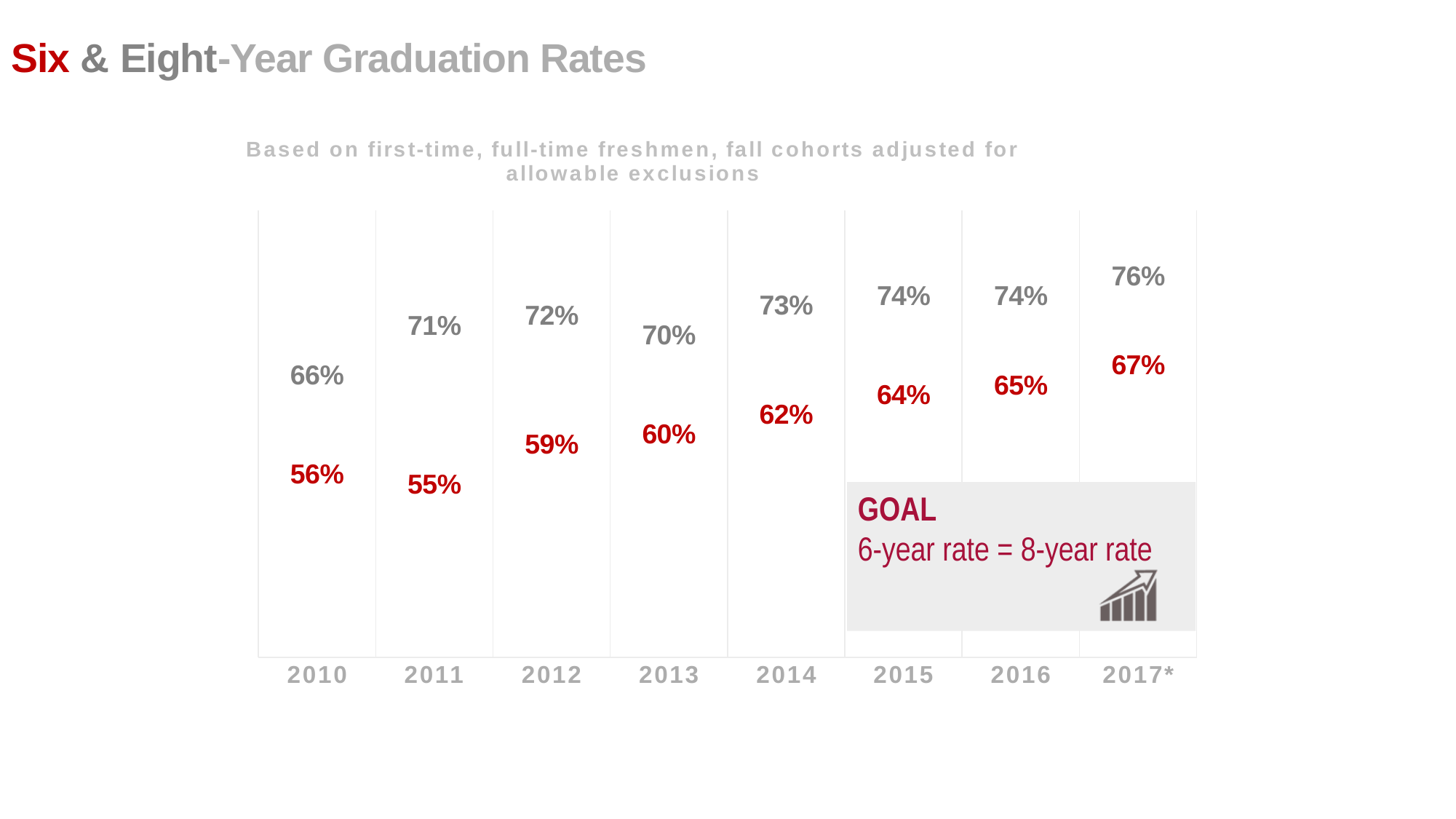
Which year has the lowest eight-year graduation rate (gray labels)? 2010 How many years are shown on the x axis? 8 Which year has the lowest six-year graduation rate (red labels)? 2011 Do the six-year graduation rates (red labels) generally rise or fall from 2011 to 2017*? rise What is the eight-year graduation rate (gray label) for 2011? 71% What is the six-year graduation rate (red label) for 2017*? 67% What is the eight-year graduation rate (gray label) for 2014? 73% Which is larger, the eight-year rate for 2012 or the eight-year rate for 2013? 2012 What is the difference between the six-year rates for 2017* and 2010? 11% What is the difference between the eight-year rate and the six-year rate for 2013? 10% What is the six-year graduation rate (red label) for 2010? 56% Which year has the highest six-year graduation rate (red labels)? 2017*